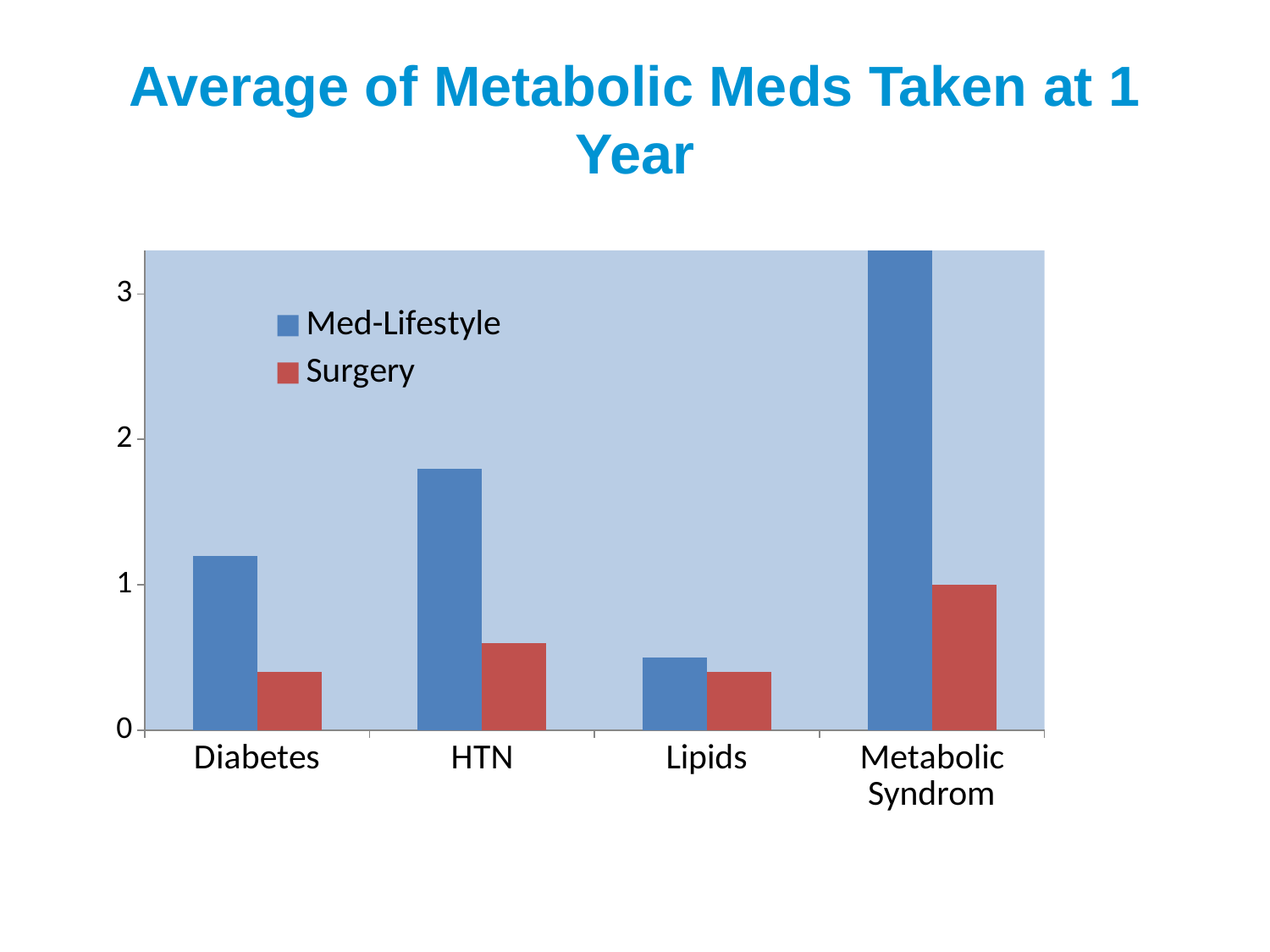
Is the Med-Lifestyle value for HTN greater or less than 2? less Is the Surgery value for HTN greater or less than 1? less How many series does the legend list? 2 How many categories are shown on the x axis? 4 For Diabetes, which is larger: the Med-Lifestyle value or the Surgery value? Med-Lifestyle What is the title of the chart? Average of Metabolic Meds Taken at 1 Year Which category has the highest Surgery value? Metabolic Syndrom Which category has the highest Med-Lifestyle value? Metabolic Syndrom Is the Med-Lifestyle value for Diabetes greater or less than 1? greater Which category has the lowest Med-Lifestyle value? Lipids What kind of chart is shown on the slide? bar chart